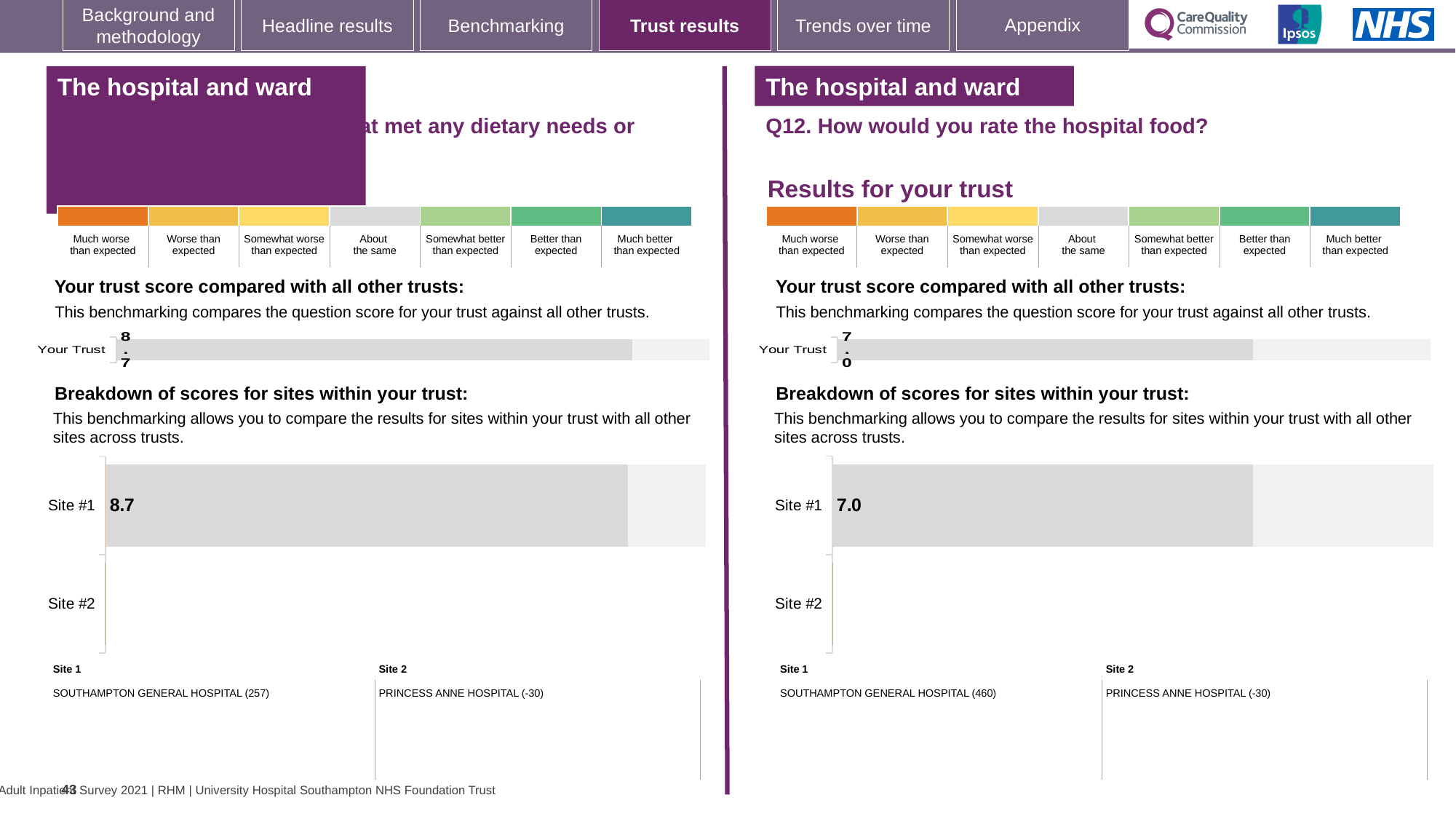
How many rating categories are shown in the colour scale above each chart, from 'Much worse than expected' to 'Much better than expected'? 7 In the right-hand breakdown of scores for sites (Q12), what is the score for Site #1? 7.0 Which is higher: the Site #1 score on the left-hand chart or the Site #1 score on the right-hand chart (Q12)? Left-hand chart (8.7) Is the Your Trust score on the right-hand chart (Q12) greater or less than the Your Trust score on the left-hand chart? less On the right-hand panel (Q12), which hospital is listed as Site 1? SOUTHAMPTON GENERAL HOSPITAL (460) On the left-hand panel, which hospital is listed as Site 2? PRINCESS ANNE HOSPITAL (-30) How many sites are listed in the right-hand breakdown of scores for sites within your trust? 2 What kind of chart is used to show the breakdown of scores for sites within your trust? Bar chart In the left-hand breakdown of scores for sites, what is the score for Site #1? 8.7 On the left-hand chart (dietary needs question), what is the score shown for Your Trust? 8.7 What is the difference between the Your Trust score on the left-hand chart (8.7) and the Your Trust score on the right-hand chart (7.0)? 1.7 On the right-hand chart for Q12 (How would you rate the hospital food?), what is the score shown for Your Trust? 7.0